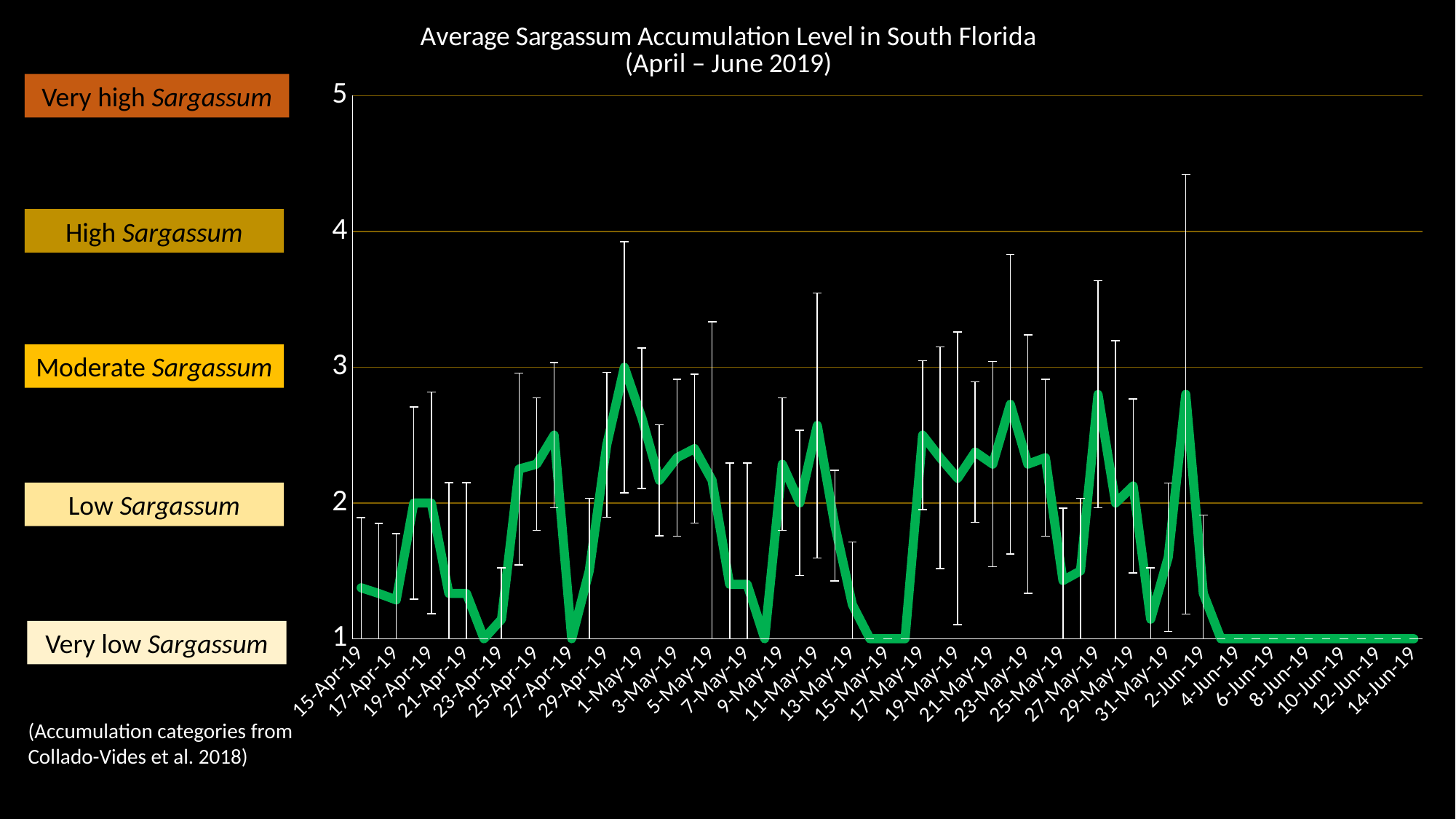
What kind of chart is shown on the slide? line chart What is the title of the chart? Average Sargassum Accumulation Level in South Florida (April – June 2019) Between 2-Jun-19 and 4-Jun-19, does the value rise or fall? fall What is the value for 14-Jun-19? 1 Is the value for 15-Apr-19 greater or less than 2? less What colour is the plotted line in the chart? green Is the value for 25-Apr-19 greater or less than 2? greater Is the value for 2-Jun-19 greater or less than 2? less Which date has the larger value, 23-Apr-19 or 25-Apr-19? 25-Apr-19